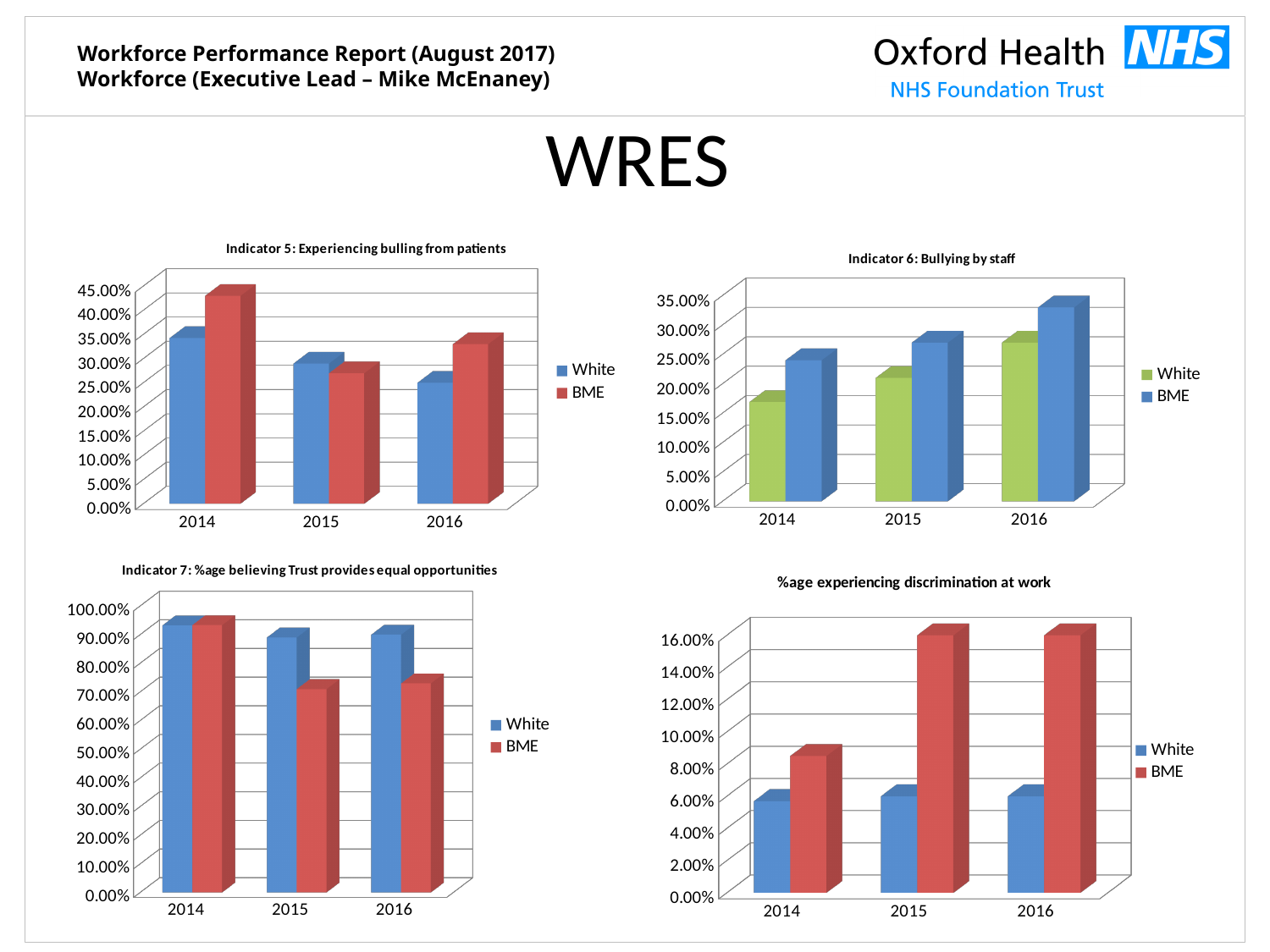
In the chart titled 'Indicator 7: %age believing Trust provides equal opportunities', how many series does the legend list? 2 In the chart titled 'Indicator 5: Experiencing bulling from patients', how many years are shown on the x axis? 3 In the chart titled 'Indicator 7: %age believing Trust provides equal opportunities', is the BME value for 2015 greater or less than 80.00%? less In the chart titled '%age experiencing discrimination at work', is the BME value for 2015 greater or less than 14.00%? greater In the chart titled 'Indicator 6: Bullying by staff', is the White value for 2014 greater or less than 20.00%? less In the chart titled 'Indicator 6: Bullying by staff', do the White values rise or fall from 2014 to 2016? rise What kind of chart is the one titled '%age experiencing discrimination at work'? bar chart In the chart titled 'Indicator 5: Experiencing bulling from patients', which is larger for 2016, White or BME? BME In the chart titled 'Indicator 5: Experiencing bulling from patients', which year has the highest BME value? 2014 In the chart titled 'Indicator 6: Bullying by staff', do the BME values rise or fall from 2014 to 2016? rise